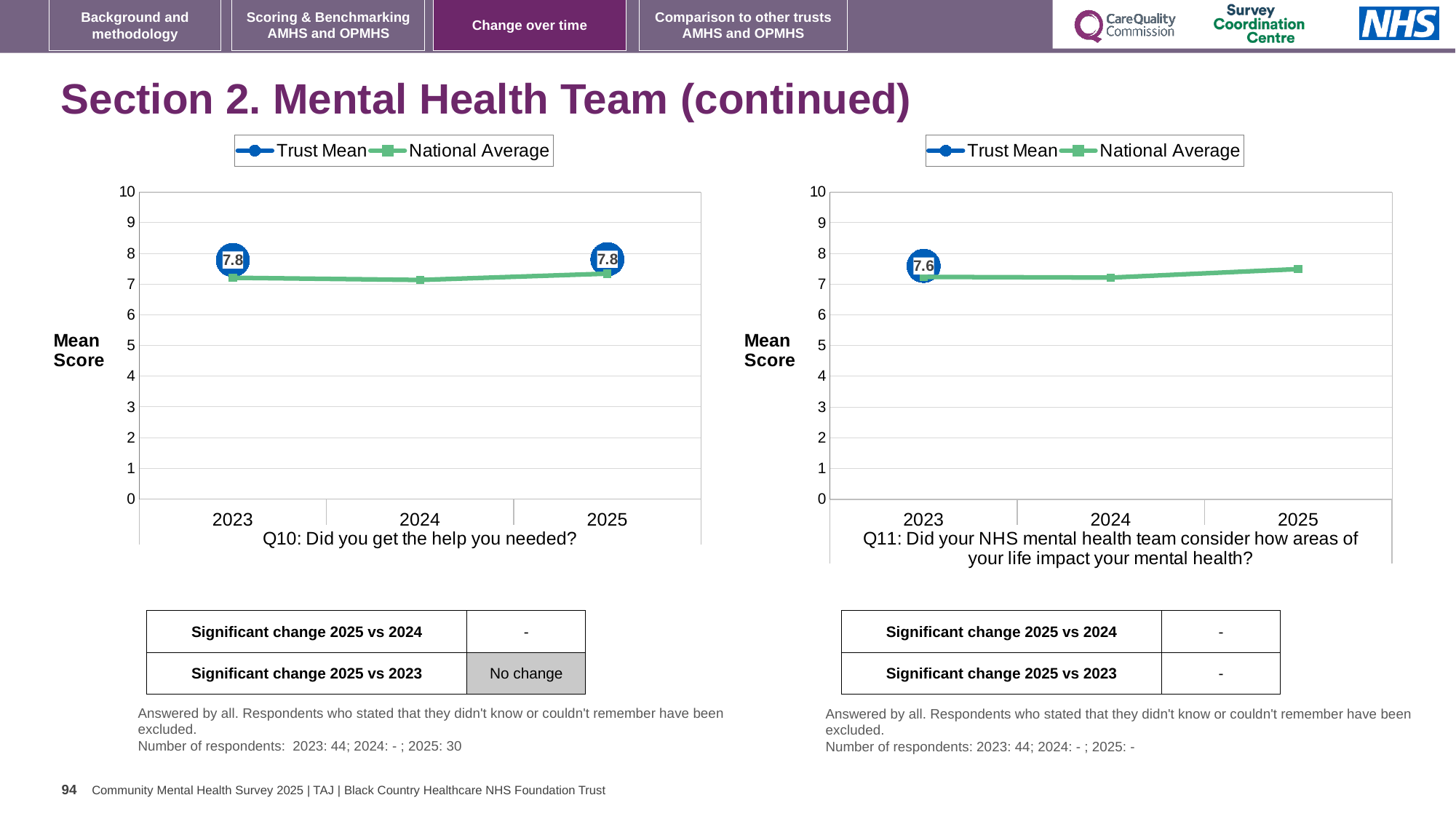
On the Q10 chart, what is the difference between the Trust Mean for 2025 and the Trust Mean for 2023? 0 On the Q10 chart, is the National Average value for 2024 greater or less than 5? greater On the Q10 chart, which is larger in 2023: the Trust Mean or the National Average? Trust Mean What kind of chart is the Q10 chart? Line chart On the Q11 chart, what is the Trust Mean score for 2023? 7.6 On the Q10 chart, does the Trust Mean rise, fall or stay the same between 2023 and 2025? Stays the same On the Q10 chart, what is the Trust Mean score for 2023? 7.8 On the Q11 chart, is the National Average value for 2025 greater or less than 8? less How many series does the legend of the Q11 chart list? 2 How many years are shown on the x axis of the Q10 chart? 3 What are the two legend entries on the Q10 chart? Trust Mean and National Average On the Q10 chart, what is the Trust Mean score for 2025? 7.8